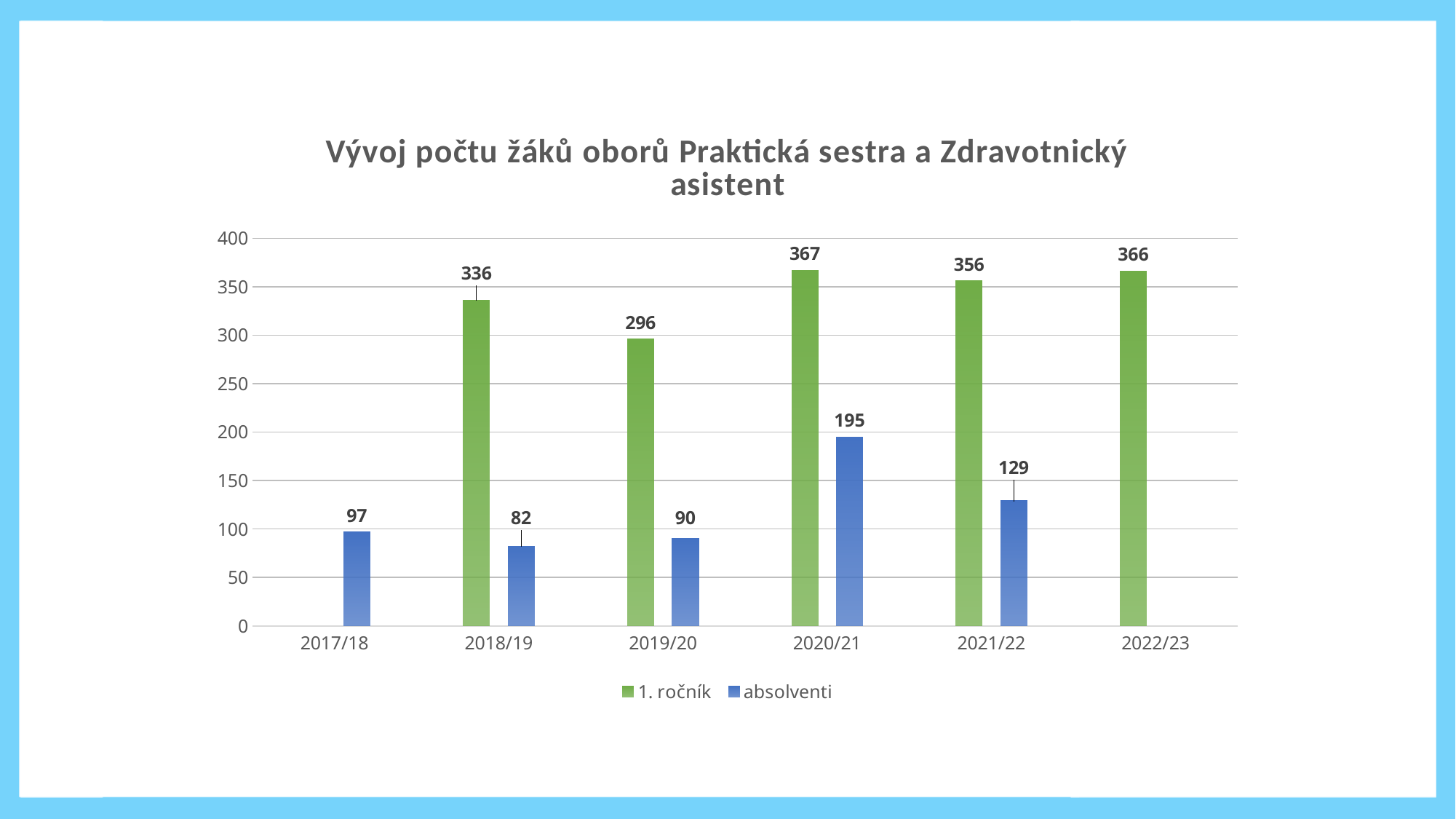
How many series does the legend list? 2 What is the difference between the '1. ročník' values for 2018/19 and 2019/20? 40 Which year has the highest value for '1. ročník'? 2020/21 Which year has the lowest value for 'absolventi'? 2018/19 Which is larger: 'absolventi' in 2020/21 or 'absolventi' in 2021/22? 2020/21 How many school years are shown on the x axis? 6 What is the value for 'absolventi' in 2017/18? 97 Is the value for '1. ročník' in 2022/23 greater or less than 350? greater Which series is shown in green? 1. ročník What is the value for '1. ročník' in 2020/21? 367 What is the value for 'absolventi' in 2021/22? 129 What kind of chart is shown on the slide? bar chart